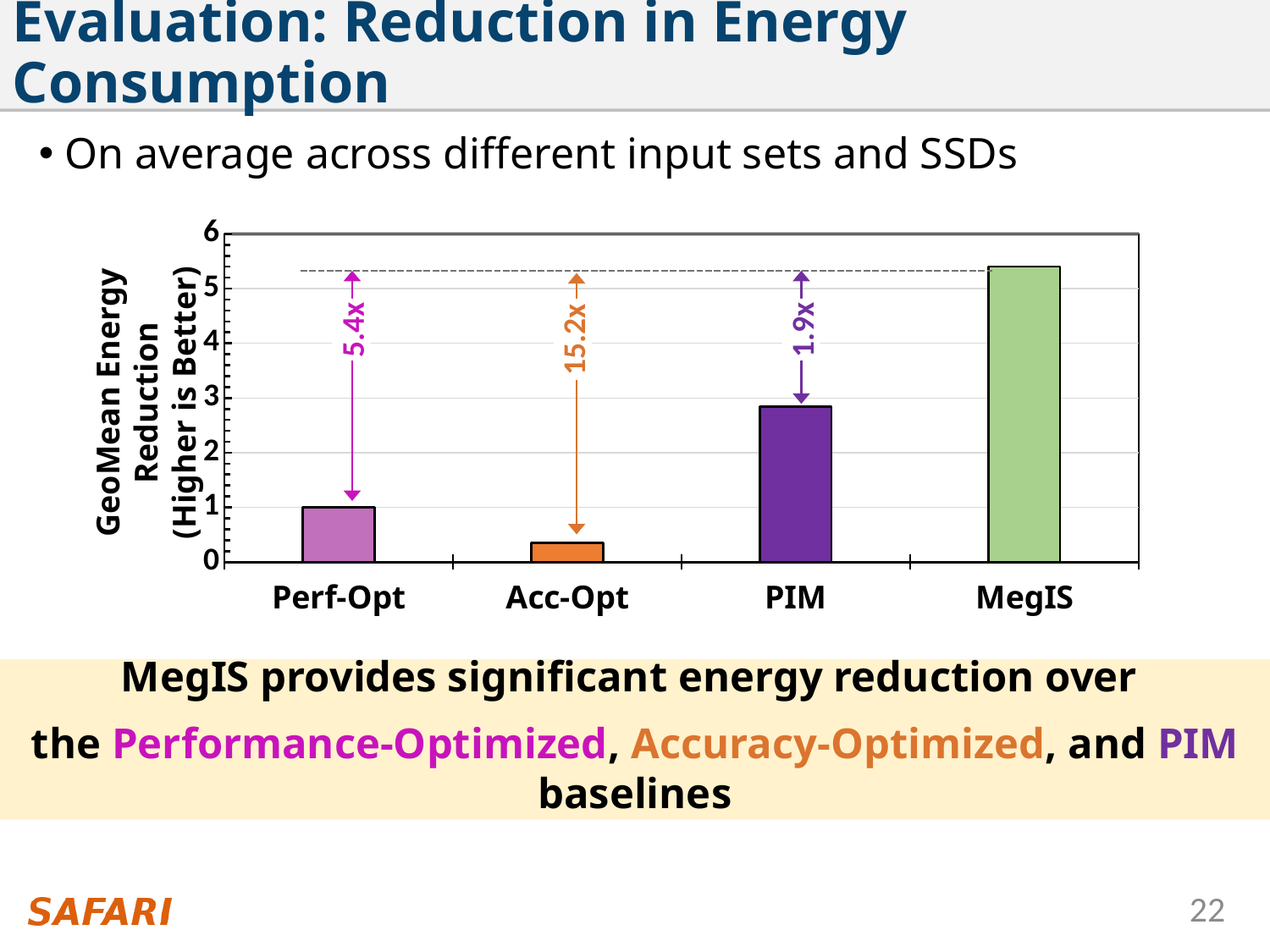
Which category has the lowest GeoMean Energy Reduction? Acc-Opt What kind of chart is shown on the slide? bar chart Is the value for PIM greater or less than 2? greater What improvement factor is annotated above the Acc-Opt bar? 15.2x Is the value for PIM greater or less than 3? less Is the value for Acc-Opt greater or less than 1? less Which has a larger GeoMean Energy Reduction, PIM or Perf-Opt? PIM What is the label of the y axis of the chart? GeoMean Energy Reduction (Higher is Better) What improvement factor is annotated above the PIM bar? 1.9x Which category has the highest GeoMean Energy Reduction? MegIS How many categories are shown on the x axis of the chart? 4